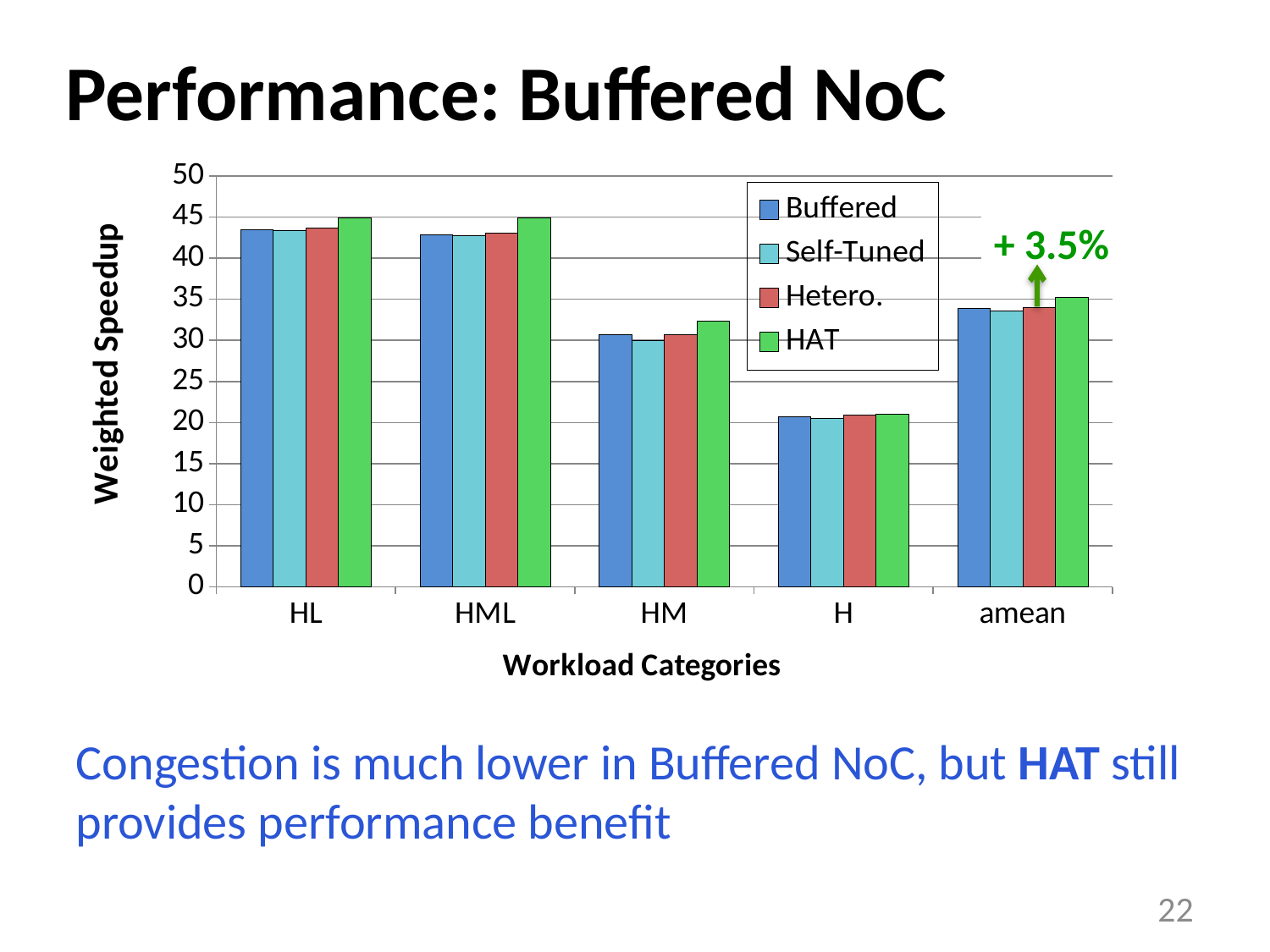
How many workload categories are shown on the x axis? 5 What is the title of the y axis? Weighted Speedup Is the weighted speedup for Buffered in the HL category greater or less than 40? greater Which workload category has the lowest weighted speedup for the HAT series? H Is the weighted speedup for Self-Tuned in the amean category greater or less than 35? less What percentage improvement is annotated above the amean group? + 3.5% Which has a higher weighted speedup for the HAT series: HML or amean? HML Is the weighted speedup for HAT in the HM category greater or less than 30? greater Which has a higher weighted speedup for the Buffered series: HM or H? HM What kind of chart is shown on the slide? bar chart How many series does the legend list? 4